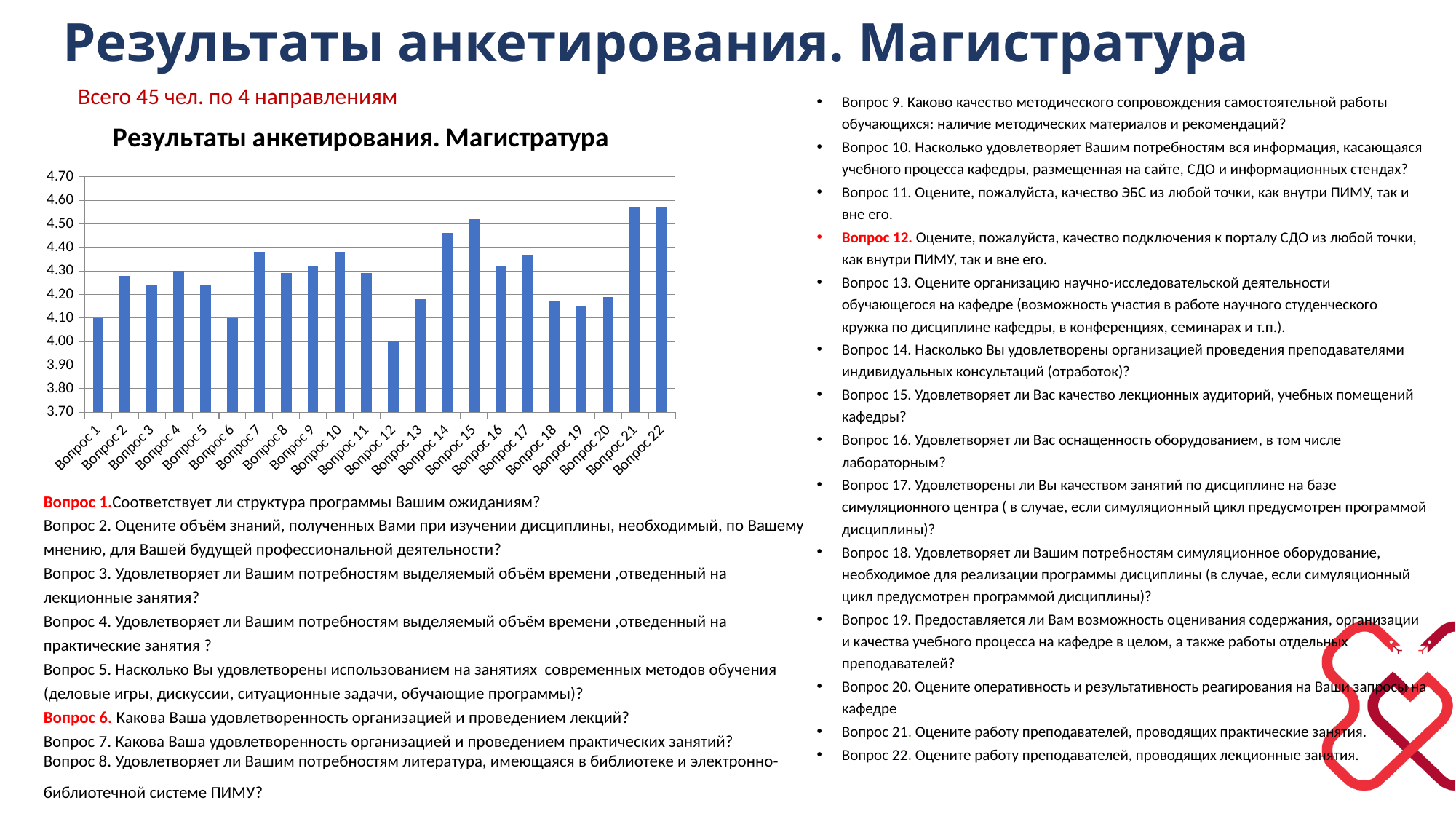
What is the value for Вопрос 1? 4.10 What is the value for Вопрос 12? 4.00 Is the value for Вопрос 2 greater or less than 4.20? greater Is the value for Вопрос 18 greater or less than 4.20? less Which is larger, the value for Вопрос 15 or the value for Вопрос 14? Вопрос 15 How many categories (questions) are plotted on the chart? 22 Which category has the lowest value on the chart? Вопрос 12 Is the value for Вопрос 14 greater or less than 4.40? greater What kind of chart is shown on the slide? bar chart What is the title of the chart? Результаты анкетирования. Магистратура Which is larger, the value for Вопрос 13 or the value for Вопрос 12? Вопрос 13